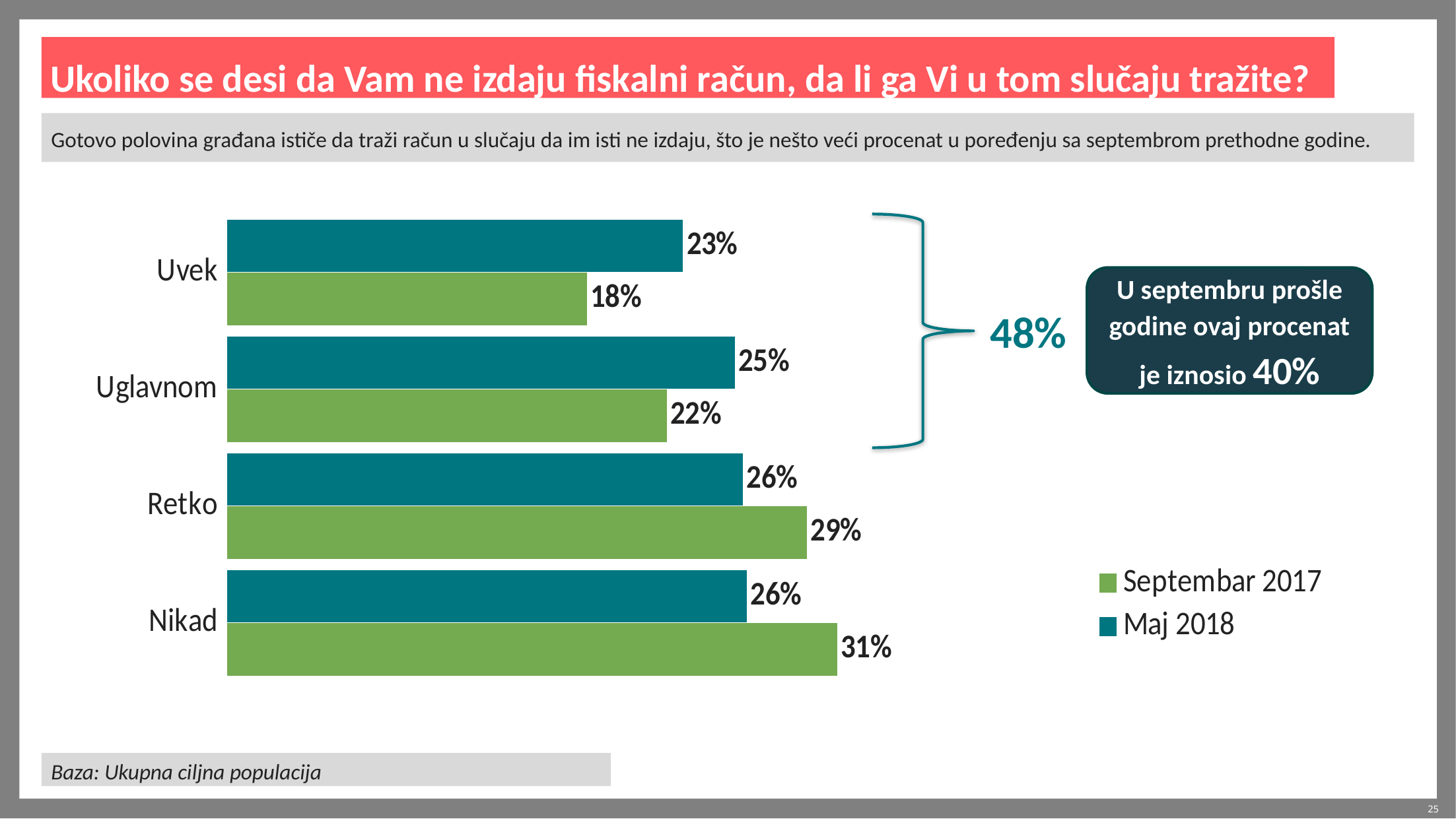
Which category has the lowest value in the Maj 2018 series? Uvek Which is larger for Retko: the Septembar 2017 value or the Maj 2018 value? Septembar 2017 What kind of chart is shown on the slide? Bar chart What is the difference between the Septembar 2017 and Maj 2018 values for Nikad? 5% Which category has the highest value in the Septembar 2017 series? Nikad How many categories are shown on the chart? 4 What combined percentage is shown by the bracket for Uvek and Uglavnom in Maj 2018? 48% What is the difference between the Maj 2018 and Septembar 2017 values for Uvek? 5% How many series does the legend list? 2 What is the value for Nikad in the Septembar 2017 series? 31% What is the value for Uvek in the Maj 2018 series? 23% What is the value for Uglavnom in the Septembar 2017 series? 22%